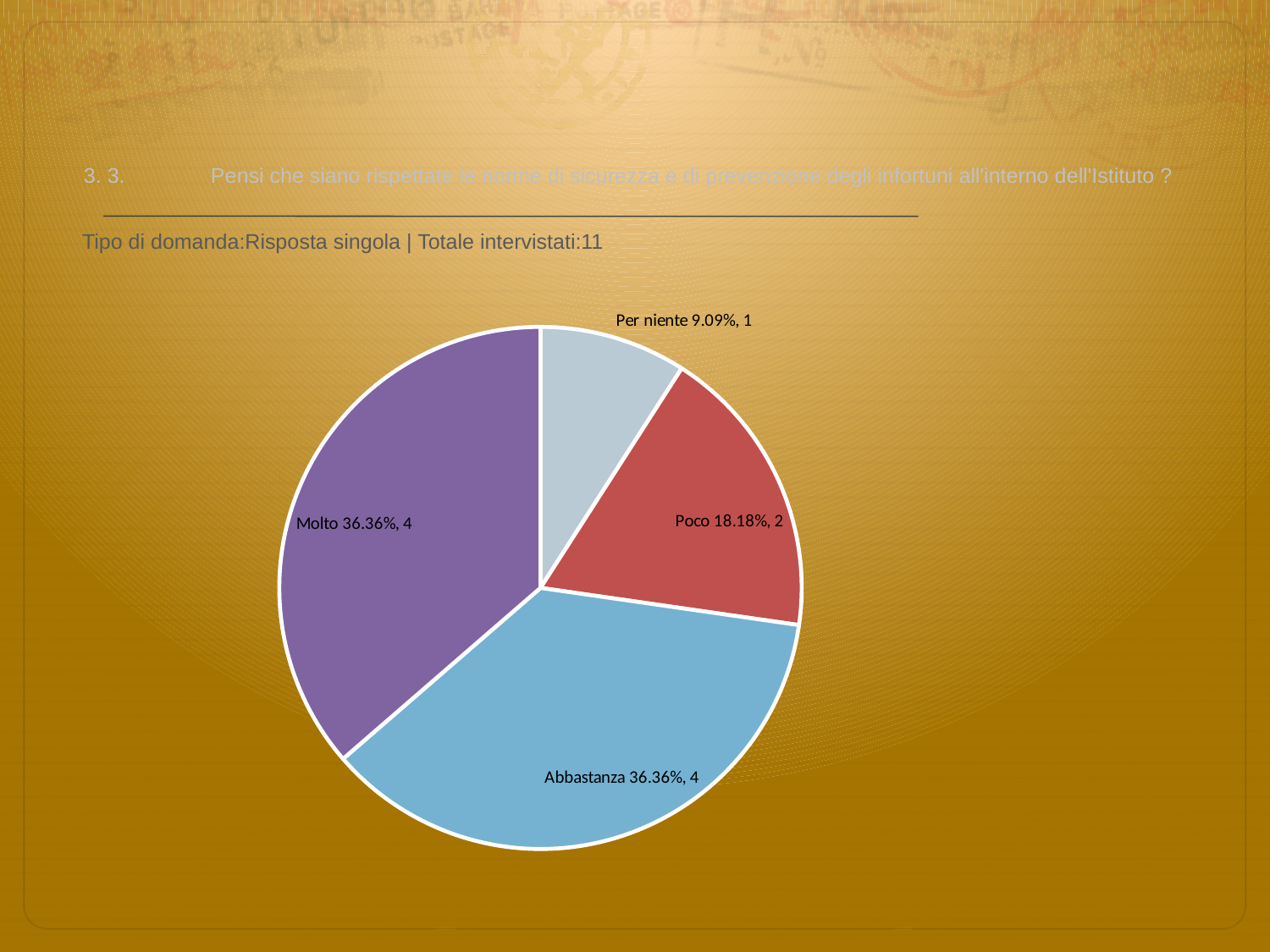
How many slices does the pie chart have? 4 What percentage share does the 'Poco' slice have? 18.18% Which slice is larger, 'Poco' or 'Per niente'? Poco What is the difference in respondent count between 'Abbastanza' and 'Poco'? 2 What is the total number of respondents across all slices of the pie? 11 What colour is the 'Molto' slice? purple How many respondents answered 'Abbastanza'? 4 How many respondents answered 'Poco'? 2 Which category has the smallest slice of the pie? Per niente How many respondents answered 'Molto'? 4 What percentage share does the 'Per niente' slice have? 9.09% What kind of chart is shown on the slide? pie chart